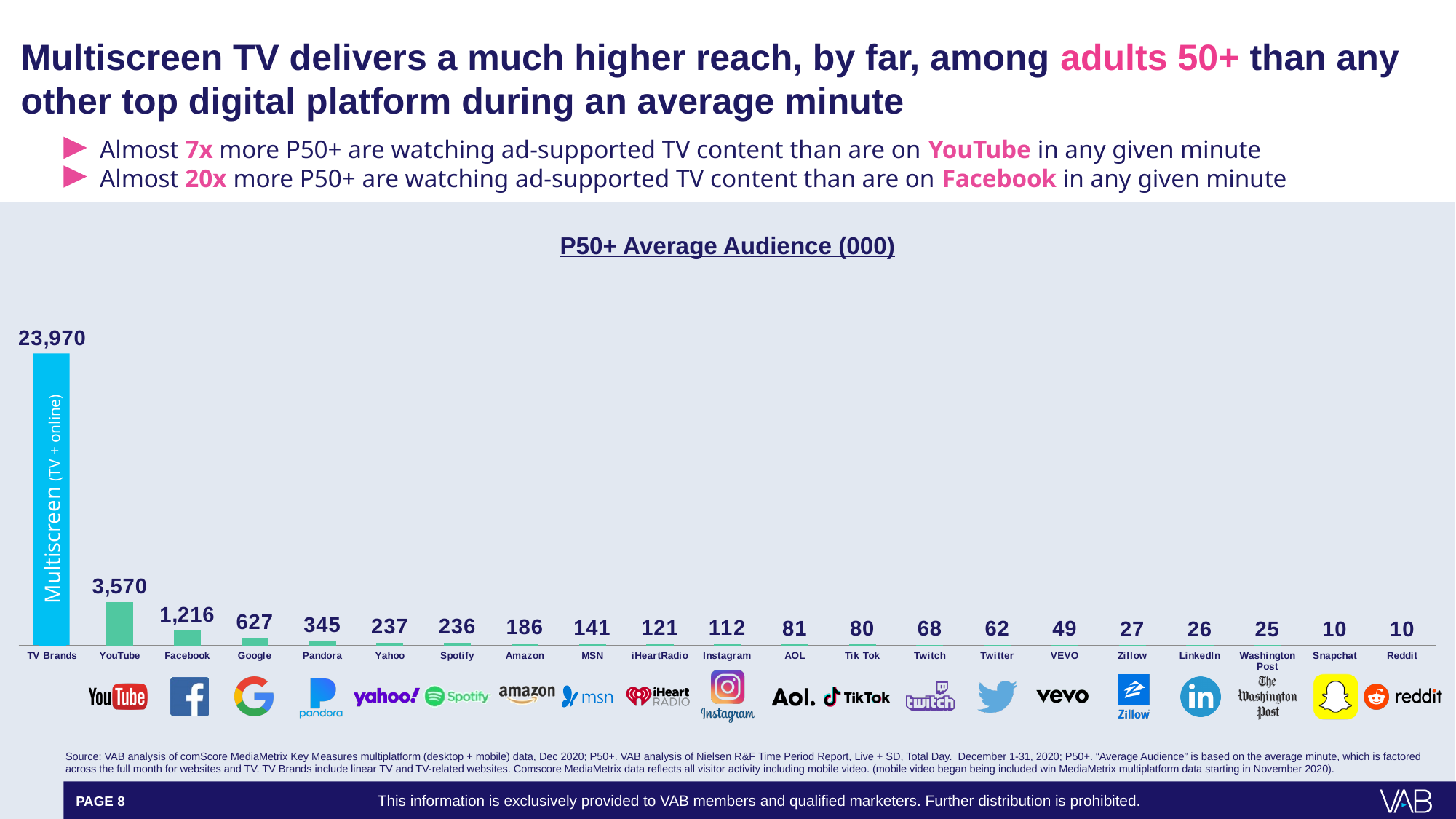
What kind of chart is shown on the slide? Bar chart What is the P50+ average audience (000) for YouTube? 3,570 What is the P50+ average audience (000) for Facebook? 1,216 Which has a larger value, Google or Pandora? Google What is the title of the chart? P50+ Average Audience (000) What is the difference between the TV Brands and YouTube values? 20,400 What is the value shown for Tik Tok? 80 How many categories are plotted in the chart? 21 Which category has the highest P50+ average audience? TV Brands Which has a larger value, Instagram or AOL? Instagram What is the value shown for Zillow? 27 What is the difference between the YouTube and Facebook values? 2,354